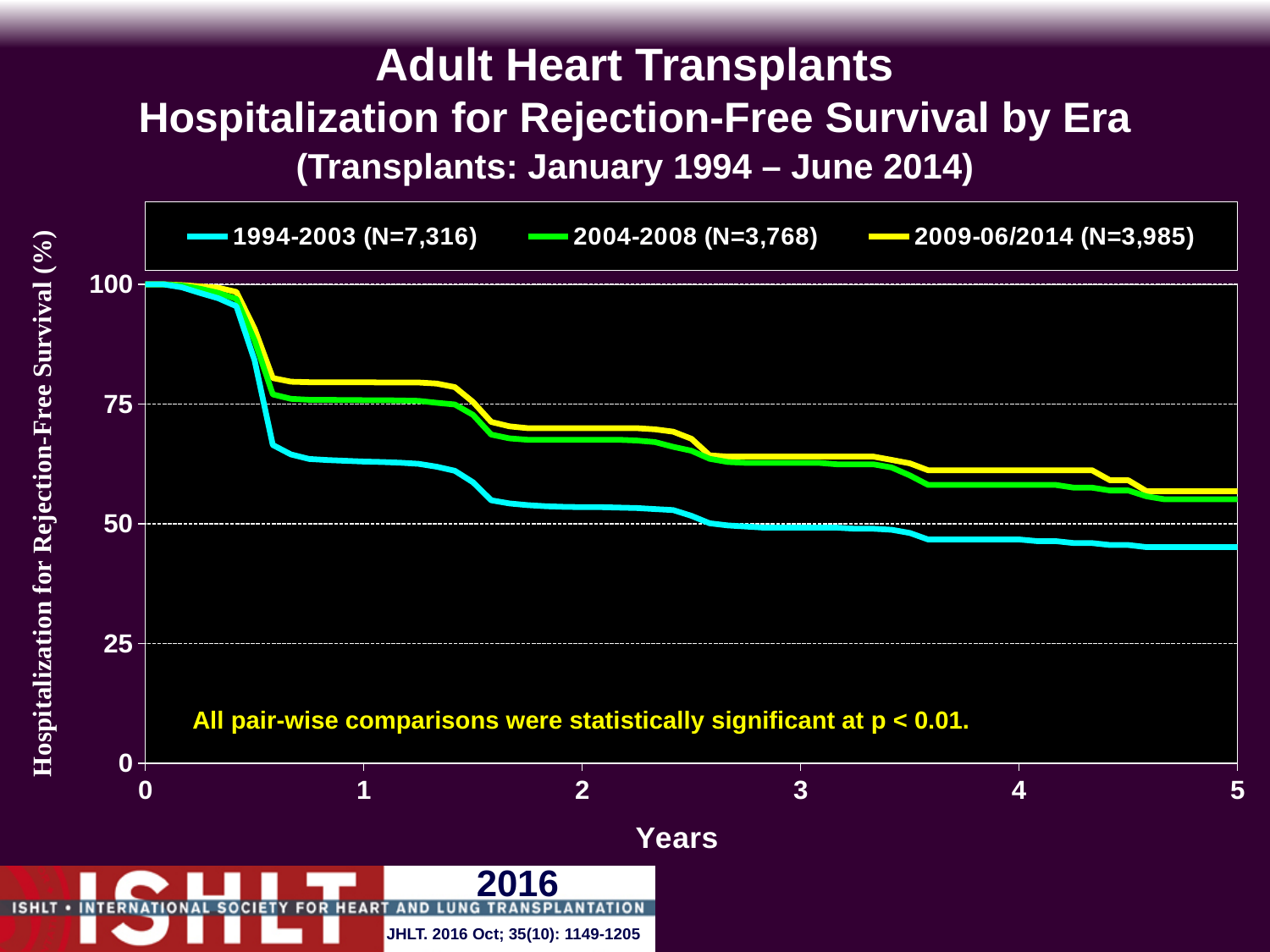
Which era has the lowest hospitalization for rejection-free survival at year 5? 1994-2003 Is the value for the 1994-2003 era at year 5 greater or less than 50? less Is the value for the 1994-2003 era at year 1 greater or less than 75? less What is the hospitalization for rejection-free survival value for the 2004-2008 era at year 0? 100 Is the value for the 2004-2008 era at year 5 greater or less than 50? greater At year 3, which era has the higher survival: 1994-2003 or 2009-06/2014? 2009-06/2014 What is the N shown in the legend for the 1994-2003 era? N=7,316 How many series does the legend list? 3 Do the survival values for the 1994-2003 era rise or fall as years increase? fall What kind of chart is shown on the slide? line chart Which era has the highest hospitalization for rejection-free survival at year 1? 2009-06/2014